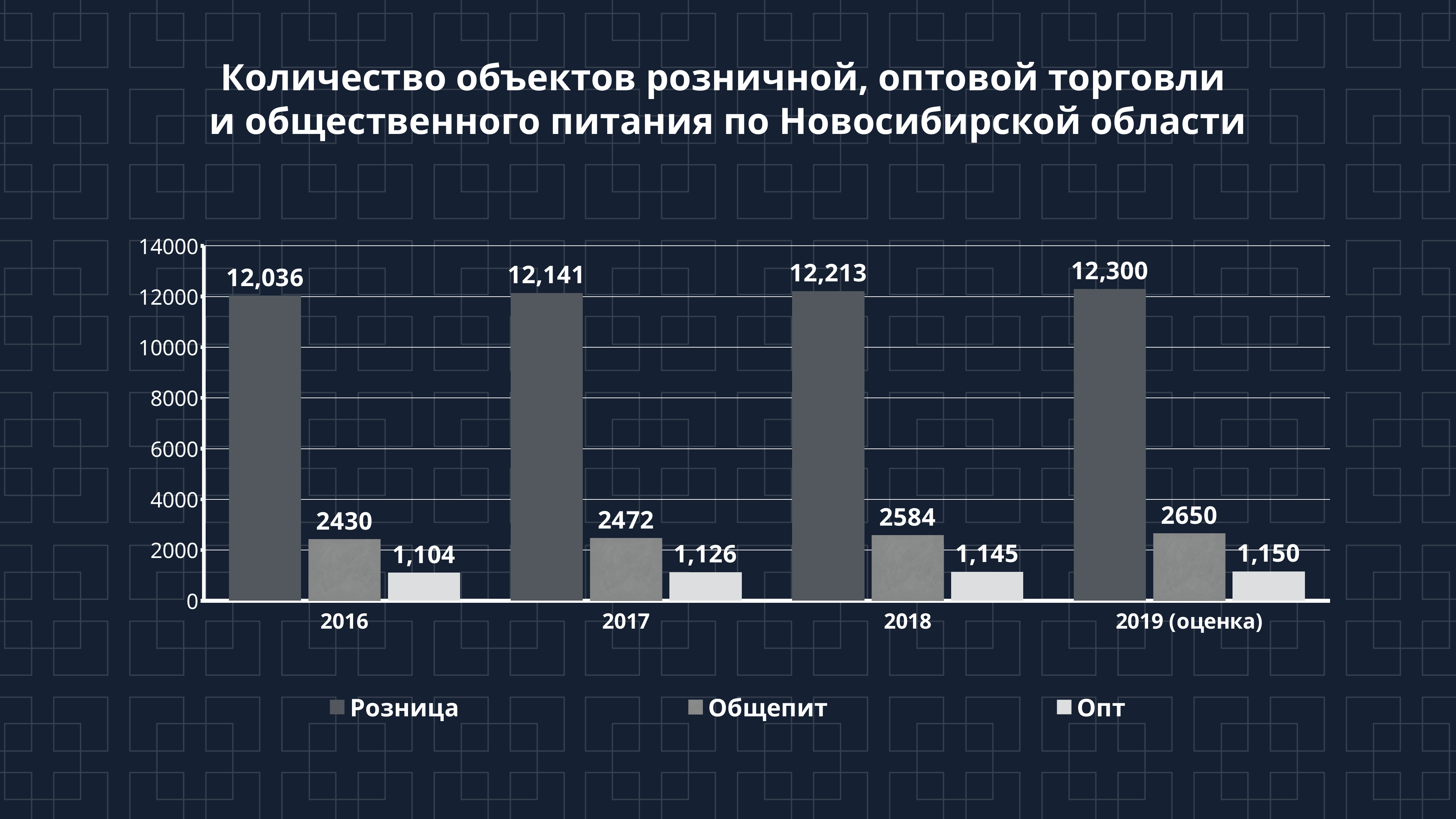
What is the difference between the Общепит values for 2018 and 2017? 112 What is the value for Розница in 2016? 12,036 What is the value for Общепит in 2018? 2584 How many years are shown on the x axis? 4 In which year is the Опт value lowest? 2016 What is the difference between the Розница values for 2019 (оценка) and 2016? 264 Is the value for Общепит in 2019 (оценка) greater or less than 4000? less How many series does the legend list? 3 In which year is the Розница value highest? 2019 (оценка) Which is larger: Общепит in 2017 or Опт in 2018? Общепит in 2017 What is the value for Опт in 2019 (оценка)? 1,150 Do the Розница values rise or fall from 2016 to 2019 (оценка)? rise